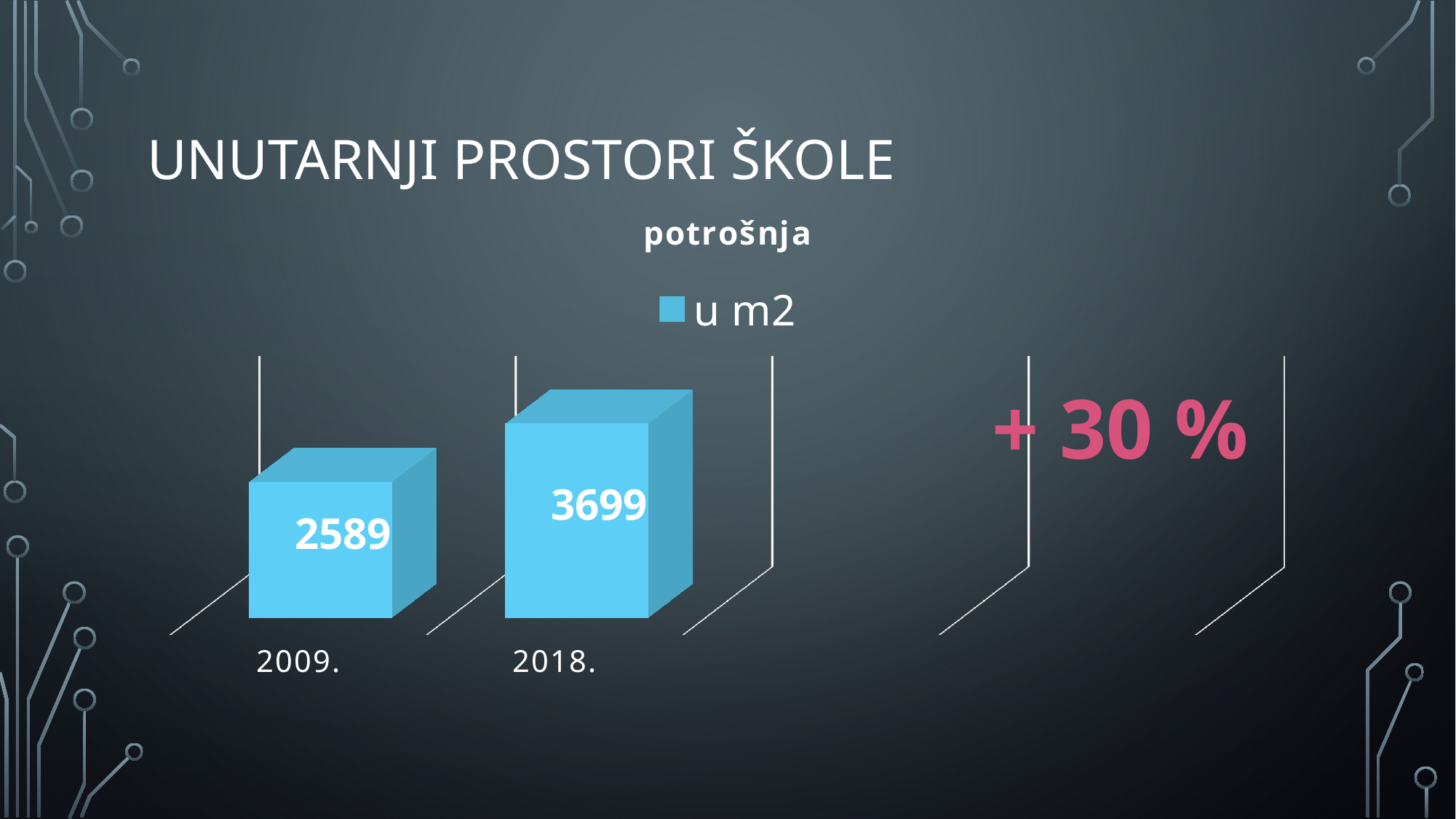
What is the name of the series in the legend? u m2 Do the values rise or fall from 2009. to 2018.? rise What is the value for 2018.? 3699 What is the difference between the values for 2018. and 2009.? 1110 What kind of chart is shown? bar chart Which year has the lower value? 2009. Which year has the higher value? 2018. How many series does the legend list? 1 What is the value for 2009.? 2589 What is the title of the chart? potrošnja Is the value for 2018. larger or smaller than the value for 2009.? larger How many categories are shown on the x axis? 2